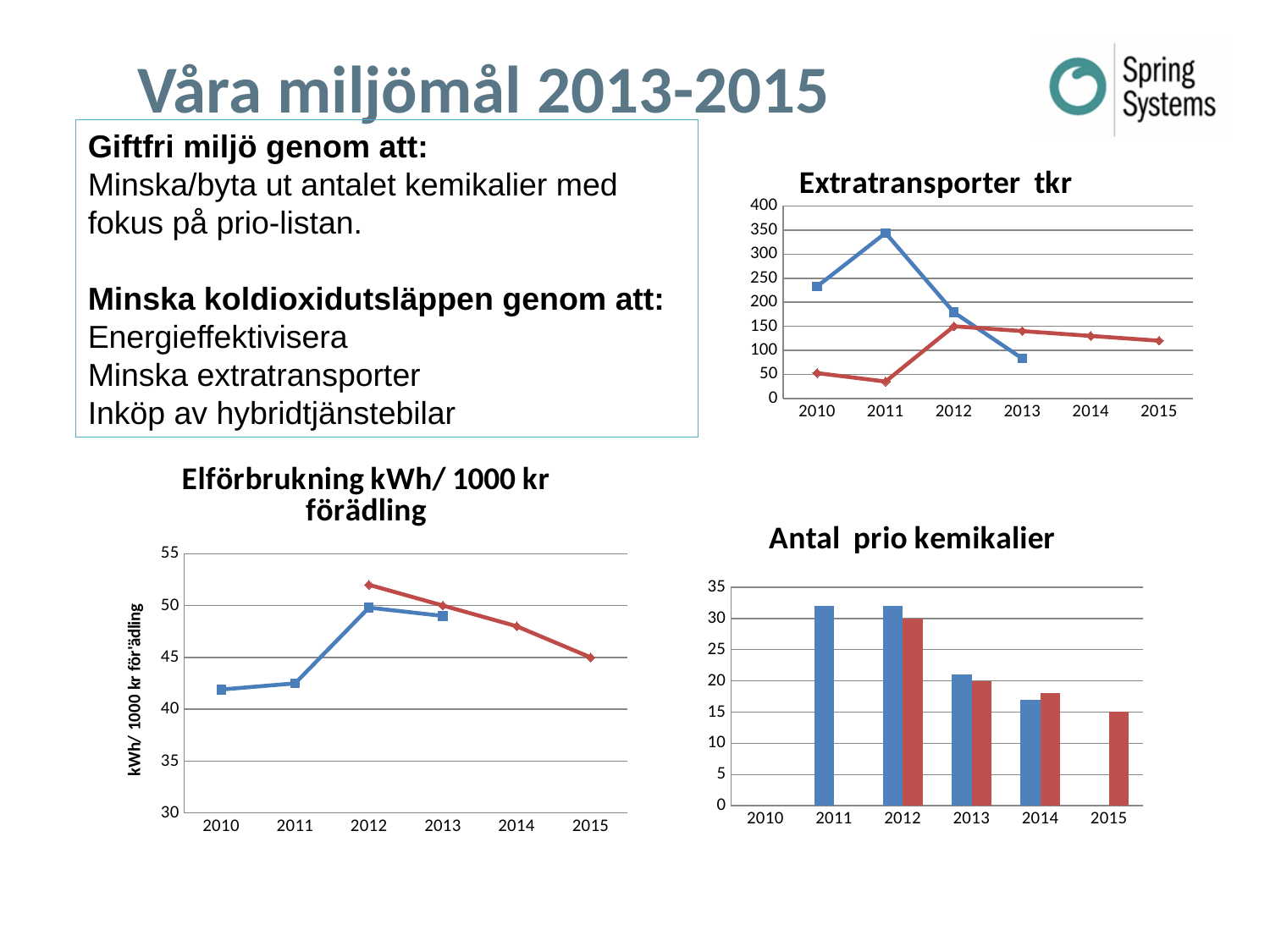
What kind of chart is the "Antal prio kemikalier" chart? bar chart In the "Extratransporter tkr" chart, is the red line's value for 2011 greater or less than 50? less In the "Extratransporter tkr" chart, in which year does the blue line reach its highest value? 2011 What kind of chart is the "Extratransporter tkr" chart? line chart In the "Antal prio kemikalier" chart, which year has the lowest red bar? 2015 In the "Antal prio kemikalier" chart, which is larger: the blue bar for 2013 or the blue bar for 2014? 2013 What is the y-axis label of the "Elförbrukning kWh/ 1000 kr förädling" chart? kWh/ 1000 kr förädling In the "Elförbrukning kWh/ 1000 kr förädling" chart, is the blue line's value for 2010 greater or less than 45? less In the "Extratransporter tkr" chart, is the blue line's value for 2011 greater or less than 300? greater How many years are shown on the x axis of the "Extratransporter tkr" chart? 6 In the "Elförbrukning kWh/ 1000 kr förädling" chart, does the red line rise or fall from 2012 to 2015? fall